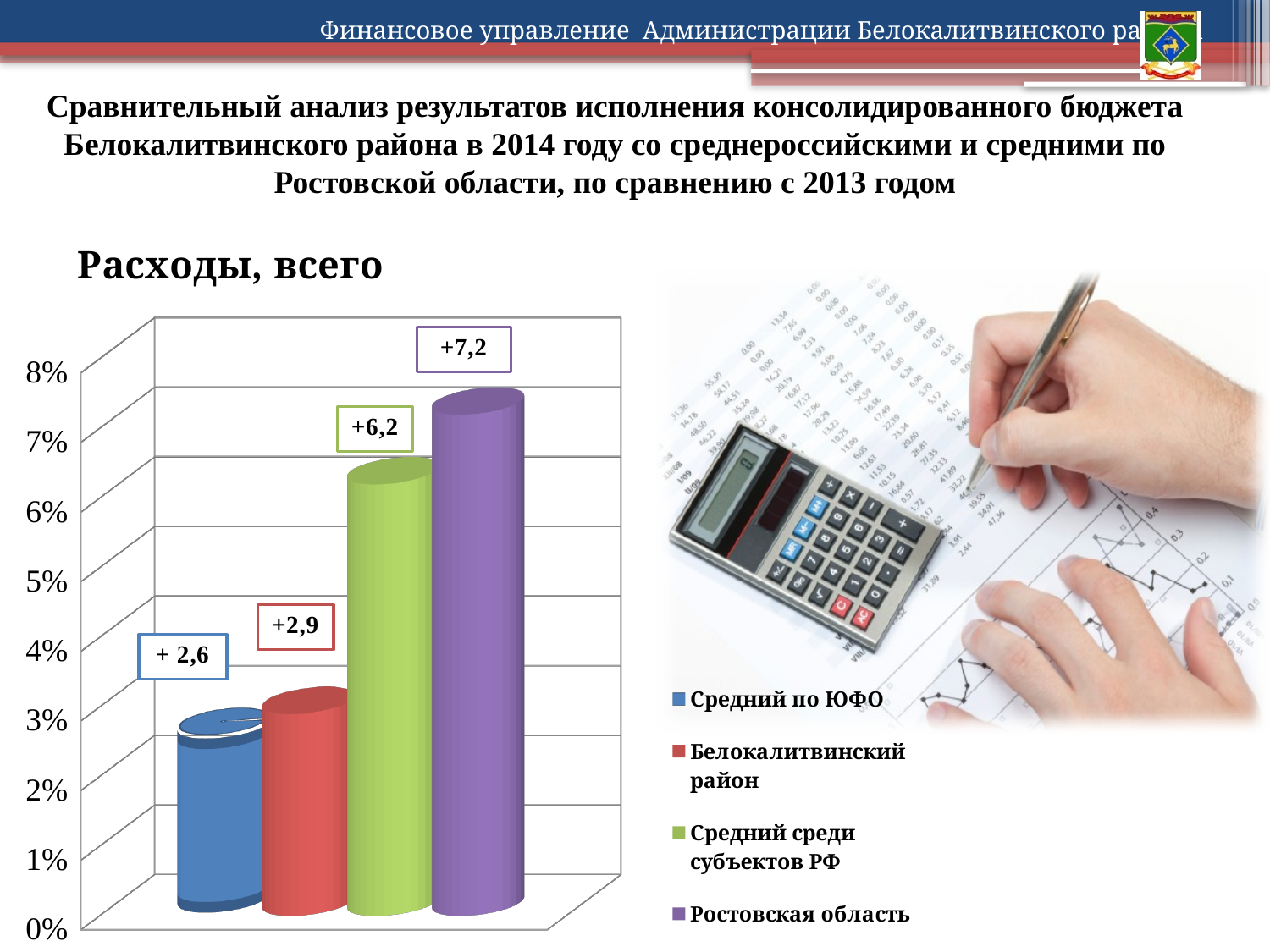
What is the title of the chart? Расходы, всего What kind of chart is shown on the slide? Bar chart Which is larger: the value for Белокалитвинский район or the value for Средний среди субъектов РФ? Средний среди субъектов РФ What is the value shown for Белокалитвинский район? +2,9 What is the value shown for Ростовская область in the chart? +7,2 How many series does the legend list? 4 What is the value shown for Средний по ЮФО? + 2,6 Is the bar for Ростовская область greater or less than 5%? greater What is the difference between the values for Ростовская область and Средний среди субъектов РФ? 1,0 Which series has the highest value in the chart? Ростовская область Which series has the lowest value in the chart? Средний по ЮФО What is the value shown for Средний среди субъектов РФ? +6,2